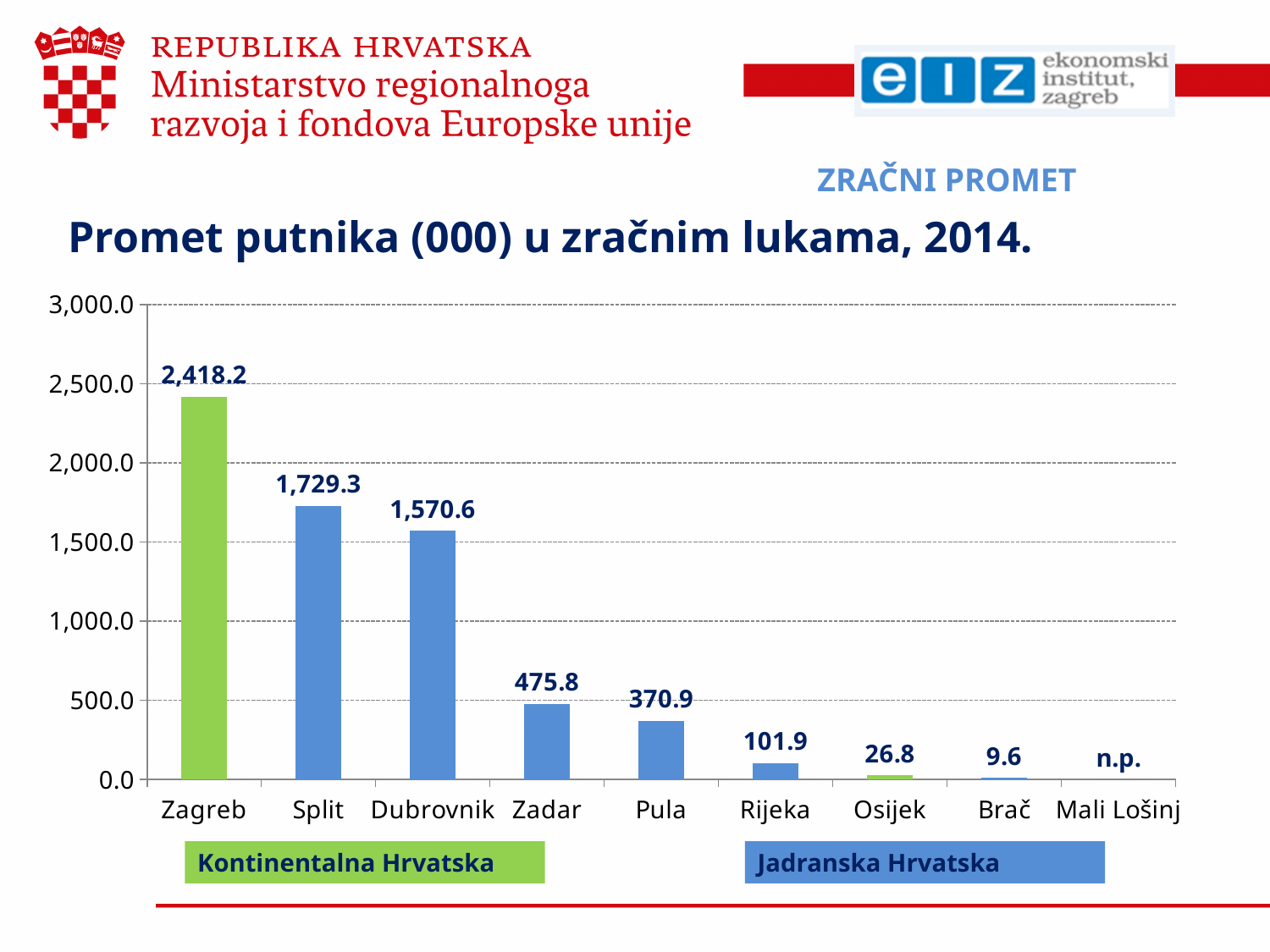
What is the difference between the values for Split and Dubrovnik? 158.7 Which airport has the highest passenger traffic? Zagreb How many airports are listed on the x axis? 9 What is the value for Dubrovnik? 1,570.6 Do the values rise or fall from left to right along the x axis? fall Which group do the green bars represent according to the legend? Kontinentalna Hrvatska What kind of chart is this? bar chart What is the value for Rijeka? 101.9 What is the value for Zagreb? 2,418.2 What is shown for Mali Lošinj? n.p. Which is larger, the value for Zadar or the value for Pula? Zadar Which airport with a numeric value has the lowest passenger traffic? Brač